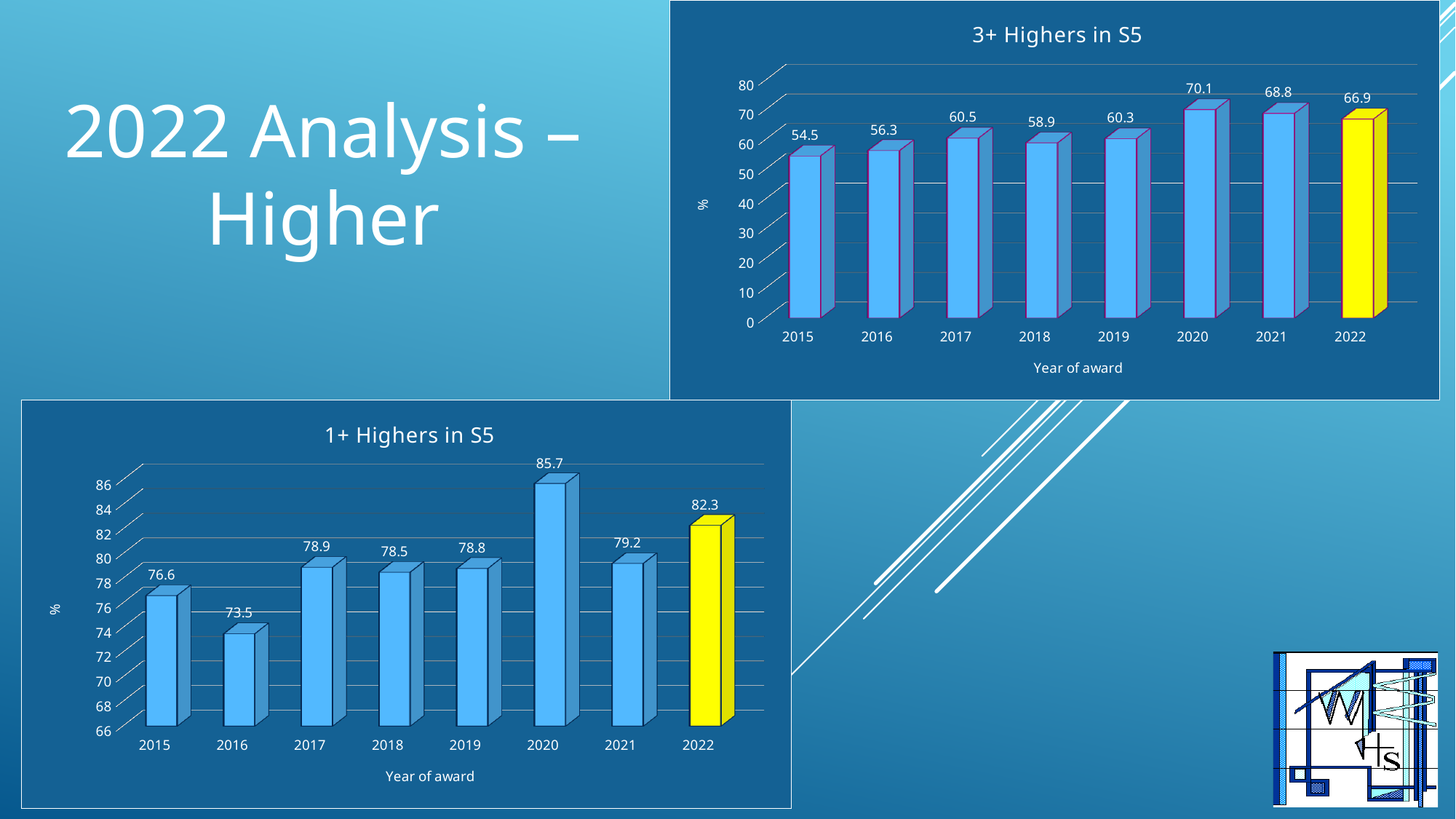
In the '3+ Highers in S5' chart, which year has the lowest value? 2015 In the '3+ Highers in S5' chart, how many years are shown on the x axis? 8 In the '3+ Highers in S5' chart, do the values generally rise or fall from 2015 to 2020? rise In the '1+ Highers in S5' chart, which year has the highest value? 2020 In the '3+ Highers in S5' chart, which year has the highest value? 2020 What kind of chart is the '1+ Highers in S5' chart? bar chart In the '1+ Highers in S5' chart, which year has the lowest value? 2016 In the '1+ Highers in S5' chart, what is the value for 2016? 73.5 What is the x-axis title of the '3+ Highers in S5' chart? Year of award In the '3+ Highers in S5' chart, what is the value for 2022? 66.9 In the '1+ Highers in S5' chart, which is larger, the value for 2021 or the value for 2022? 2022 In the '3+ Highers in S5' chart, what is the difference between the 2020 and 2022 values? 3.2